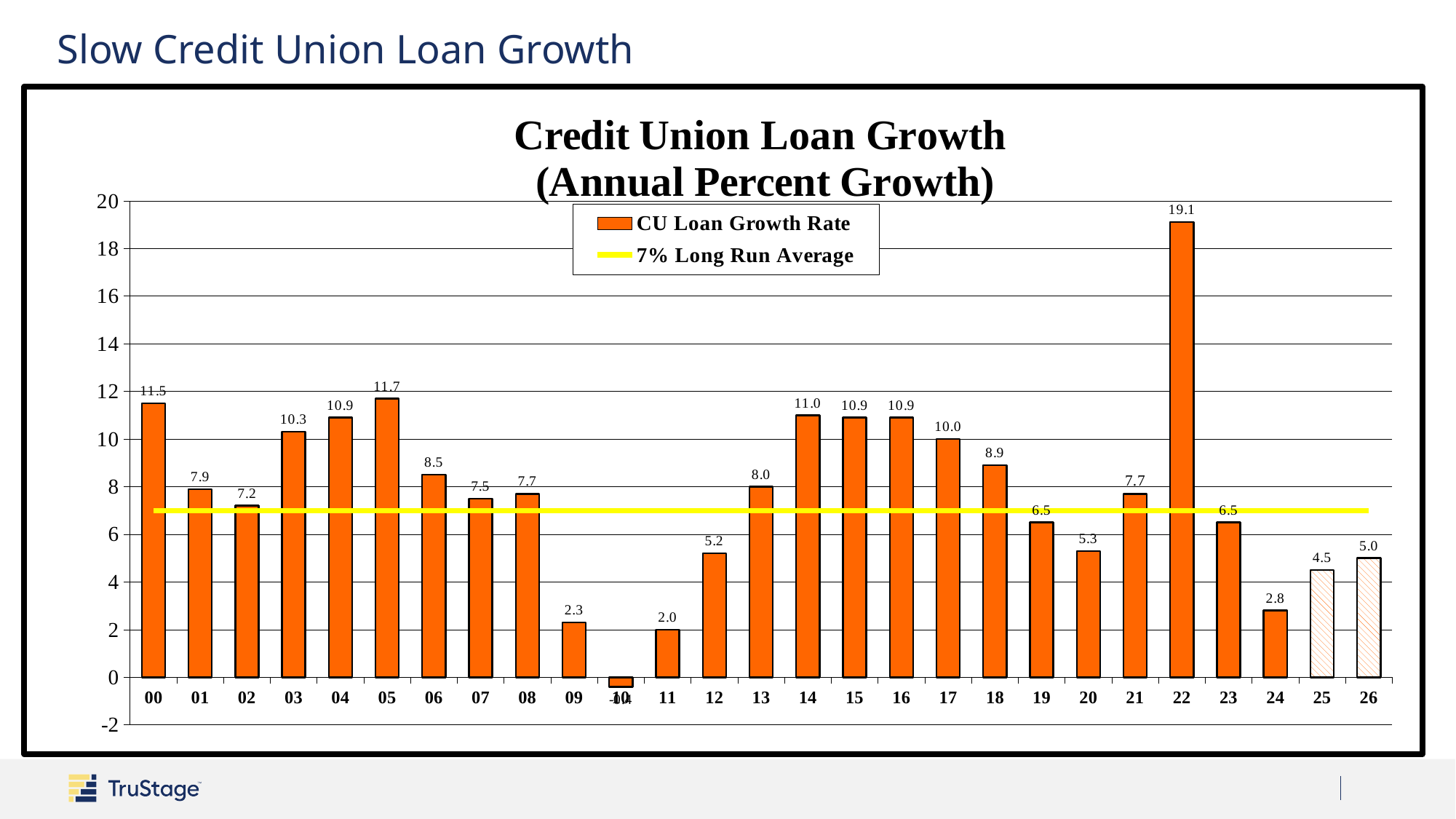
How many series does the legend list? 2 What value does the yellow horizontal line represent according to the legend? 7% Long Run Average Which year has the lowest CU Loan Growth Rate? 10 What is the difference between the CU Loan Growth Rate for 22 and for 23? 12.6 What is the CU Loan Growth Rate for 22? 19.1 What is the CU Loan Growth Rate for 25? 4.5 Is the CU Loan Growth Rate for 14 greater or less than 10? greater What kind of chart is shown? Bar chart Which year has the highest CU Loan Growth Rate? 22 How many years are shown on the x axis? 27 Which year has a higher CU Loan Growth Rate, 09 or 24? 24 What is the CU Loan Growth Rate for 05? 11.7